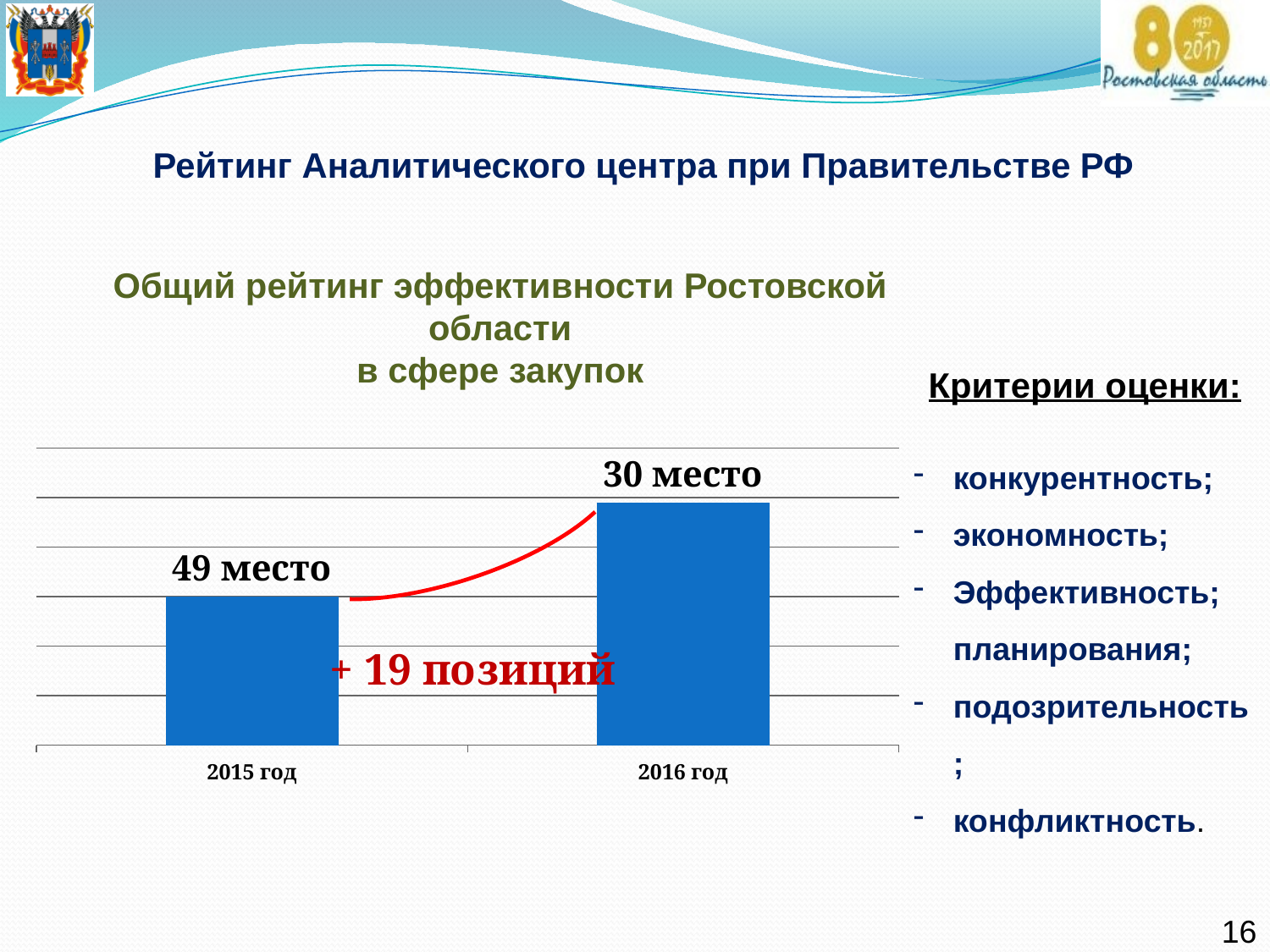
How many years (categories) are plotted on the chart? 2 What kind of chart is shown on the slide? Bar chart By how many positions did the rank change between 2015 год and 2016 год? 19 позиций What is the title of the chart? Общий рейтинг эффективности Ростовской области в сфере закупок What annotation is written in red between the two bars? + 19 позиций Does the bar height rise or fall from 2015 год to 2016 год? Rise Which year has the better (lower-numbered) rank, 2015 год or 2016 год? 2016 год Which year has the taller bar, 2015 год or 2016 год? 2016 год What rank is shown for 2015 год? 49 место What rank is shown for 2016 год? 30 место